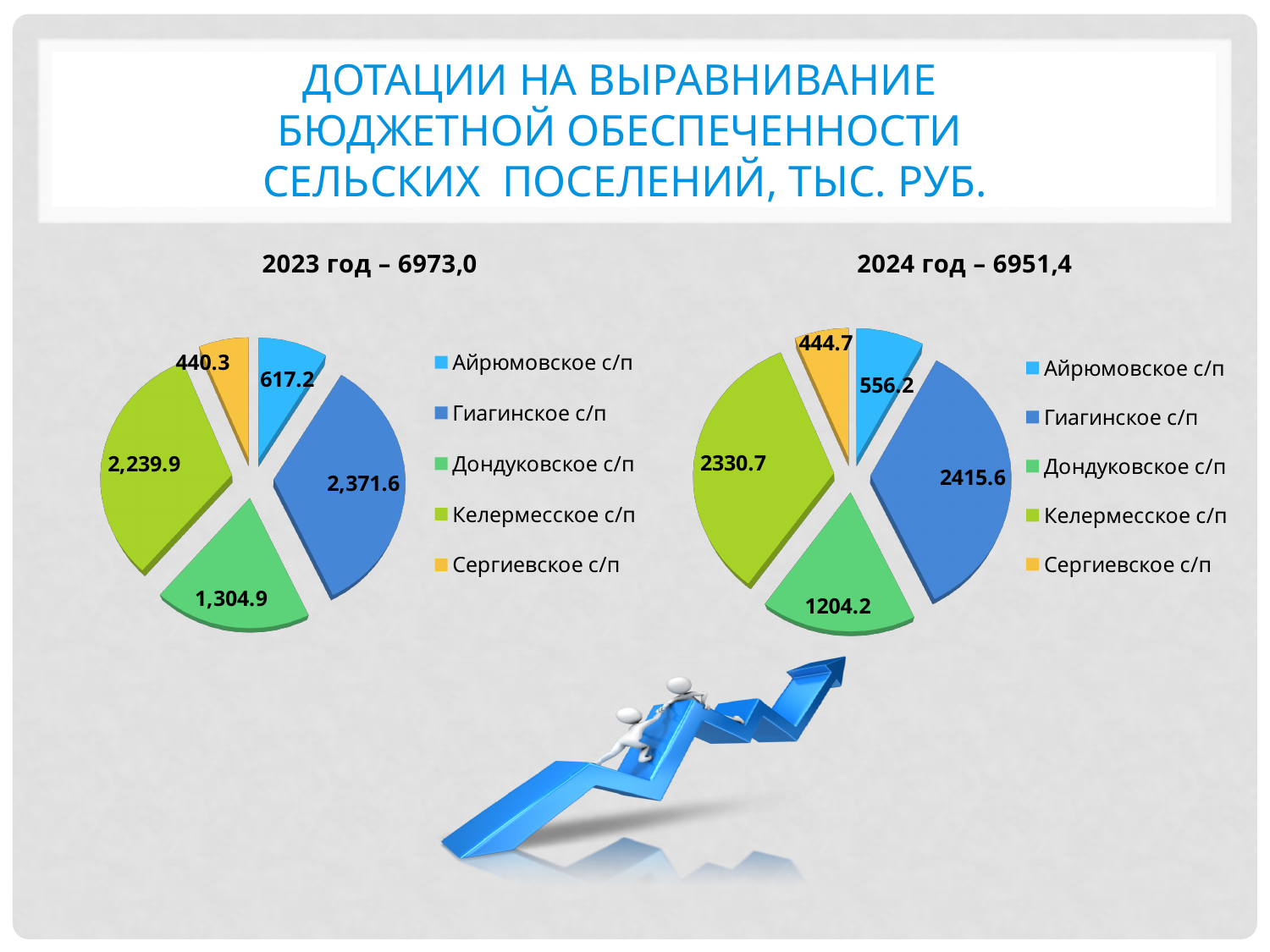
In the 2024 pie chart, what is the value for Дондуковское с/п? 1204.2 In the 2023 pie chart, what is the value for Сергиевское с/п? 440.3 How many slices does the 2024 pie chart have? 5 What type of chart is used for the 2023 data? Pie chart In the 2024 pie chart, what share of the total does Айрюмовское с/п represent? 8% In the 2023 pie chart, which is larger: Келермесское с/п or Дондуковское с/п? Келермесское с/п In the 2024 pie chart, what is the difference between the values for Гиагинское с/п and Келермесское с/п? 84.9 In the 2023 pie chart, what is the value for Гиагинское с/п? 2,371.6 What is the difference between the value for Айрюмовское с/п in the 2023 chart and in the 2024 chart? 61.0 In the 2023 pie chart, which settlement has the smallest slice? Сергиевское с/п In the 2024 pie chart, which settlement has the largest slice? Гиагинское с/п What total is shown in the heading above the 2024 pie chart? 6951,4